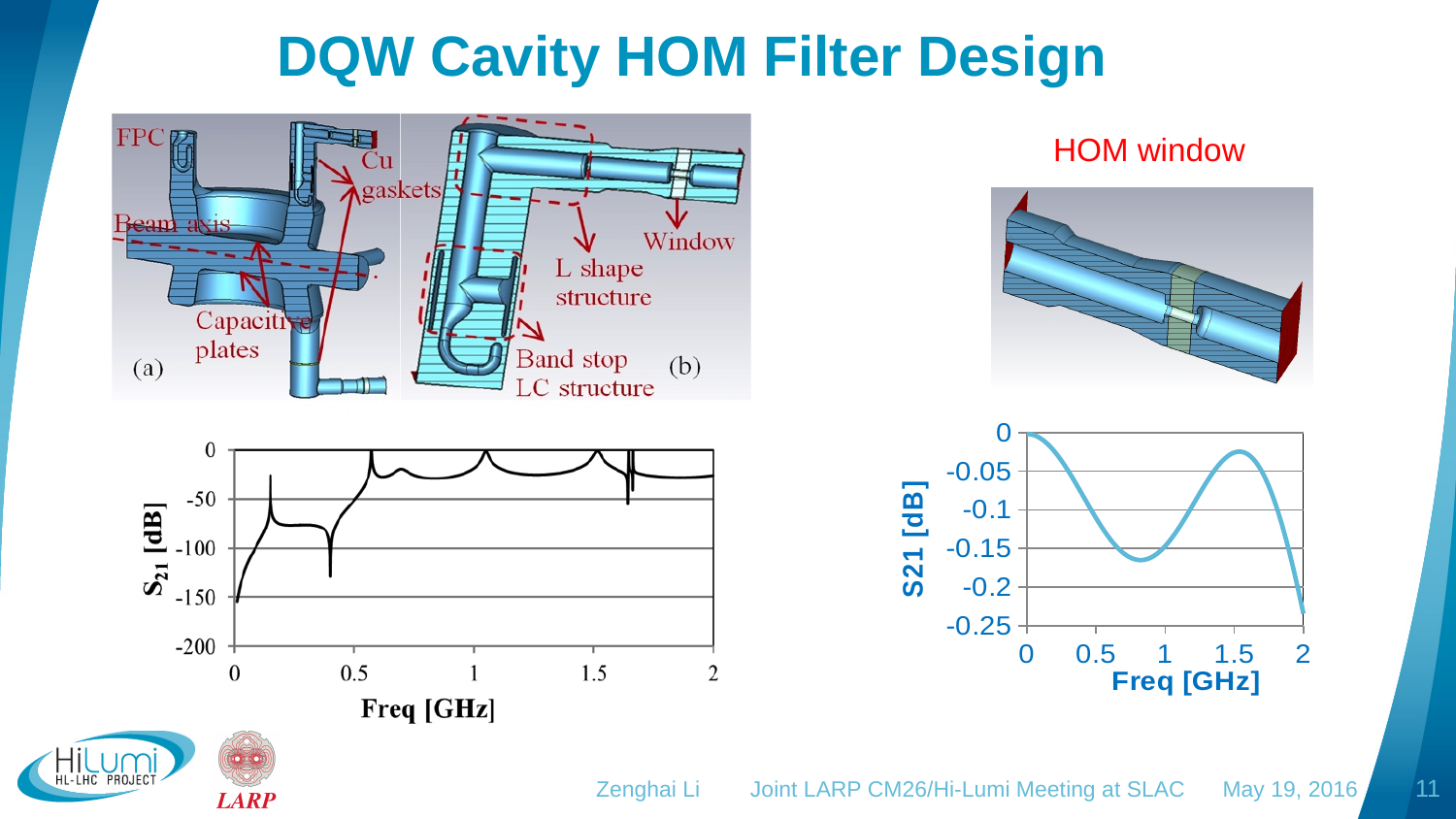
In the bottom-right chart, is the S21 value at 2 GHz greater or less than -0.2? less What kind of chart is the bottom-left chart with the S21 [dB] axis from 0 to -200? line chart In the bottom-right chart, what is the label of the y axis? S21 [dB] In the bottom-left chart, what is the label of the x axis? Freq [GHz] In the bottom-left chart, is the S21 value at 1 GHz greater or less than -50? greater In the bottom-right chart, does the S21 value rise or fall between 1.5 GHz and 2 GHz? fall In the bottom-left chart, does the S21 value rise or fall between 0 GHz and 0.15 GHz? rise What kind of chart is the bottom-right chart with the S21 [dB] axis from 0 to -0.25? line chart In the bottom-right chart, does the S21 value rise or fall between 1 GHz and 1.5 GHz? rise In the bottom-right chart, is the S21 value at 1.5 GHz greater or less than -0.05? greater